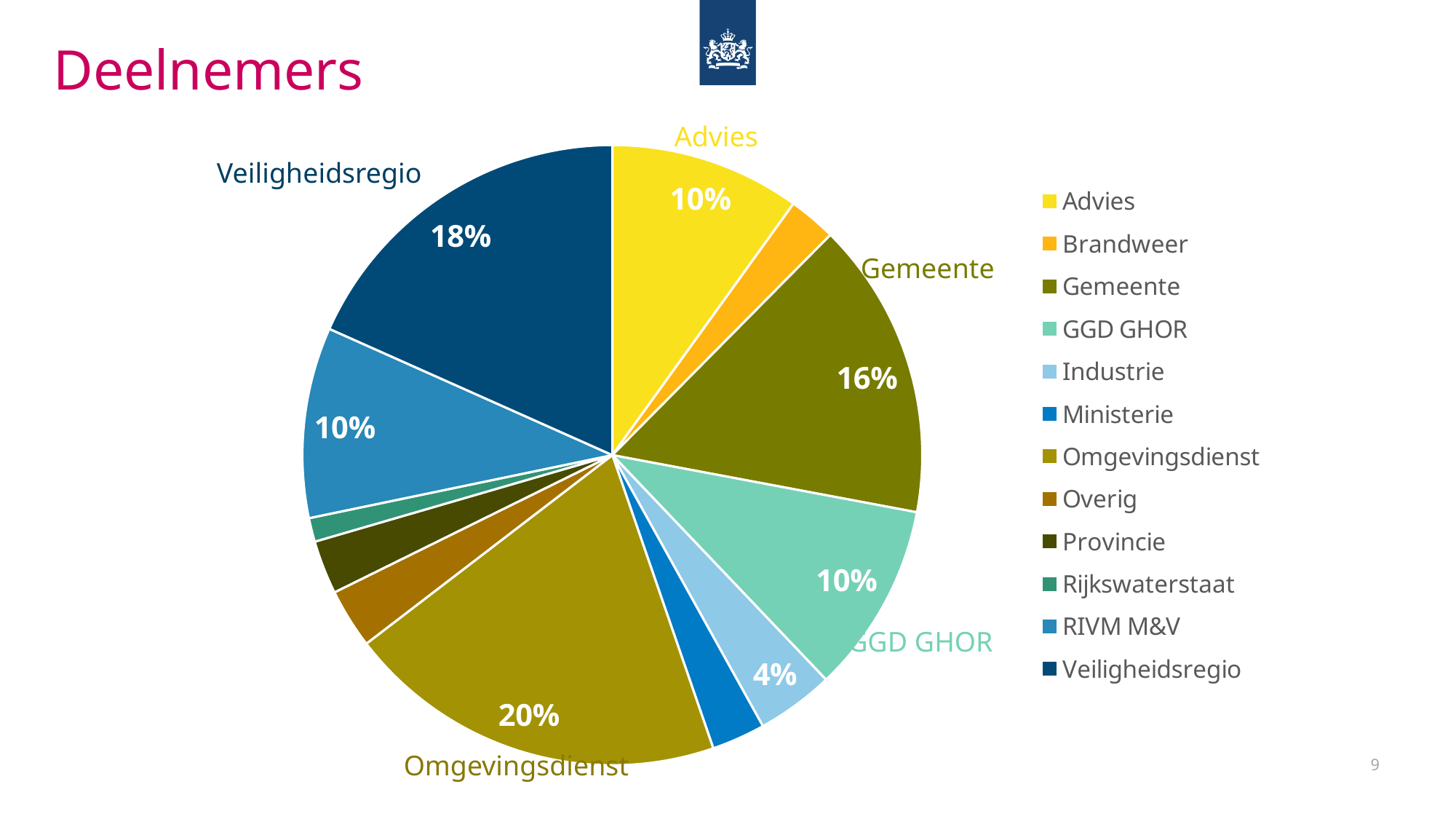
What percentage of the pie chart is Gemeente? 16% What percentage of the pie chart is Veiligheidsregio? 18% What kind of chart is shown on the slide? pie chart What percentage of the pie chart is Omgevingsdienst? 20% What percentage of the pie chart is Industrie? 4% Which slice is larger in the pie chart, Gemeente or Veiligheidsregio? Veiligheidsregio Which category is shown in yellow in the pie chart legend? Advies How many categories does the legend of the pie chart list? 12 What is the title of the slide containing the pie chart? Deelnemers What is the difference in percentage points between the Omgevingsdienst slice and the Veiligheidsregio slice? 2% What percentage of the pie chart is Advies? 10% Which category has the largest slice of the pie chart? Omgevingsdienst